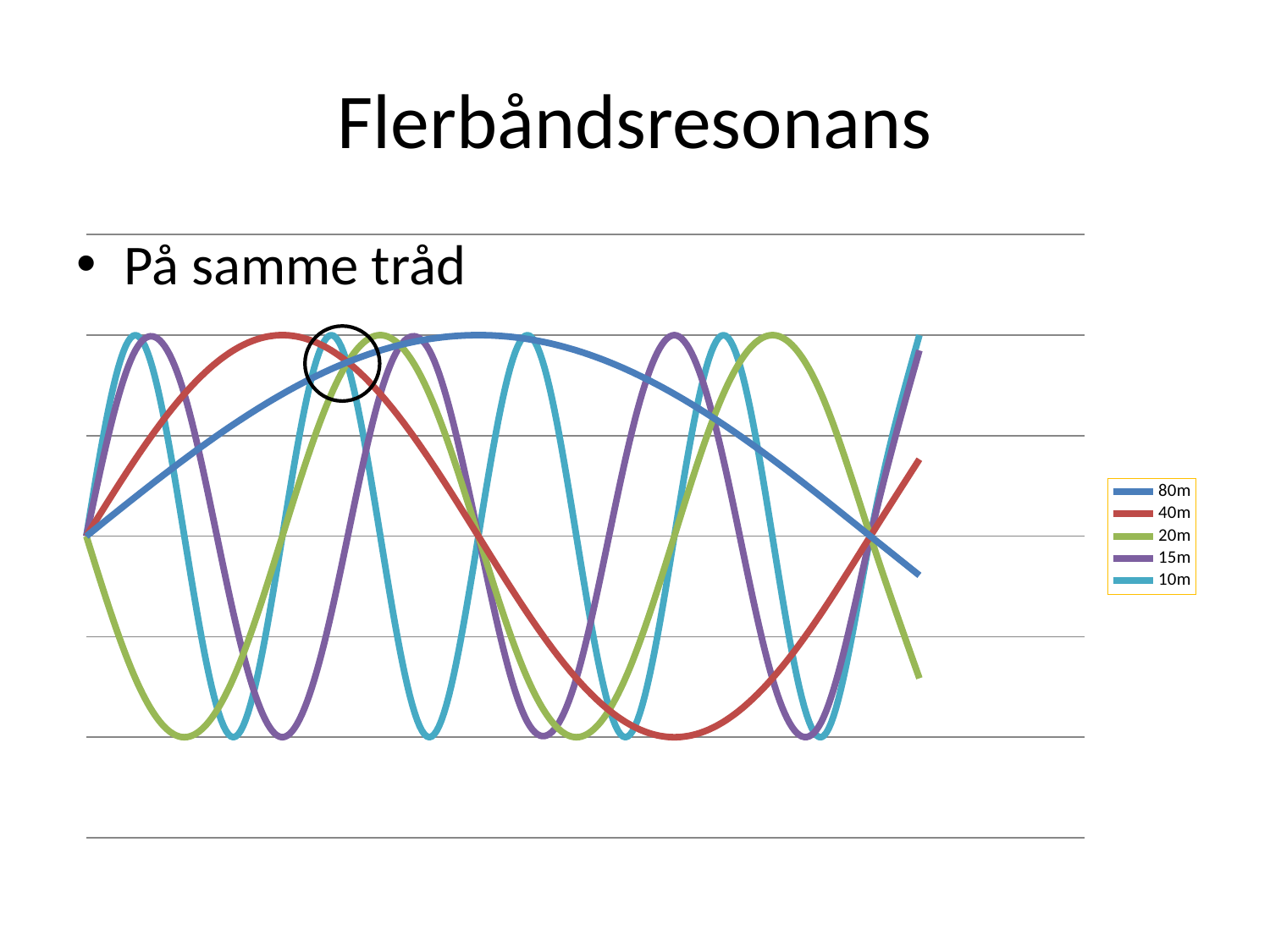
What kind of chart is shown on the slide? line chart Does the 80m series rise or fall at the right end of the x axis? fall How many series does the legend list? 5 What colour is the 80m series line? blue Which series are listed in the chart legend? 80m, 40m, 20m, 15m, 10m Does the 80m series rise or fall at the left end of the x axis? rise